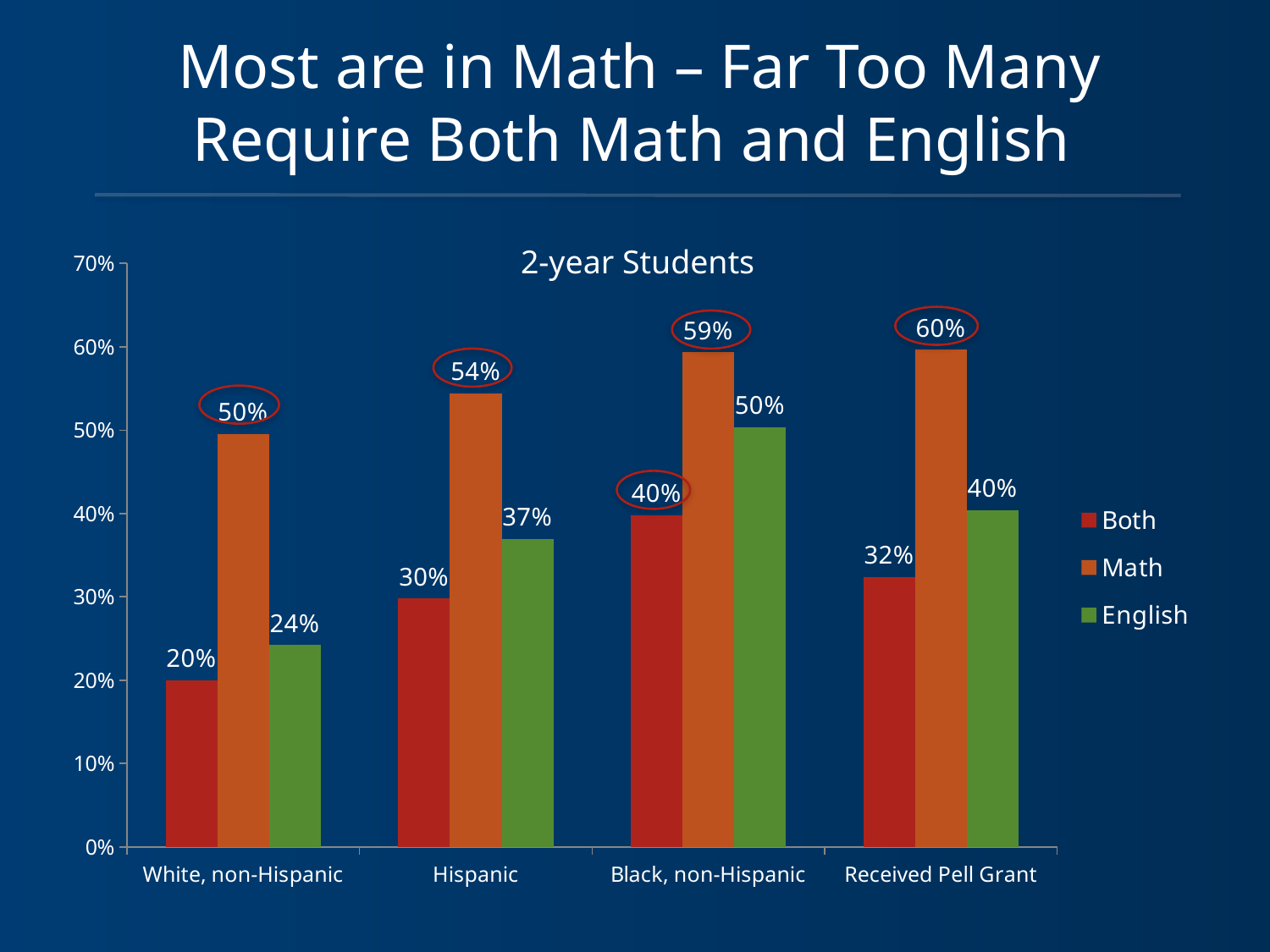
What is the difference between the Math and English values for Black, non-Hispanic students? 9% What is the English value for Received Pell Grant? 40% What kind of chart is shown? bar chart Which is larger, the Both value for Hispanic or the Both value for Received Pell Grant? Received Pell Grant Which category has the highest Math value? Received Pell Grant Which category has the lowest English value? White, non-Hispanic What is the Both value for White, non-Hispanic students? 20% What is the title of the chart? 2-year Students How many series does the legend list? 3 Is the English value for Hispanic students greater or less than 40%? less How many categories are shown on the x axis? 4 What is the Math value for Hispanic students? 54%